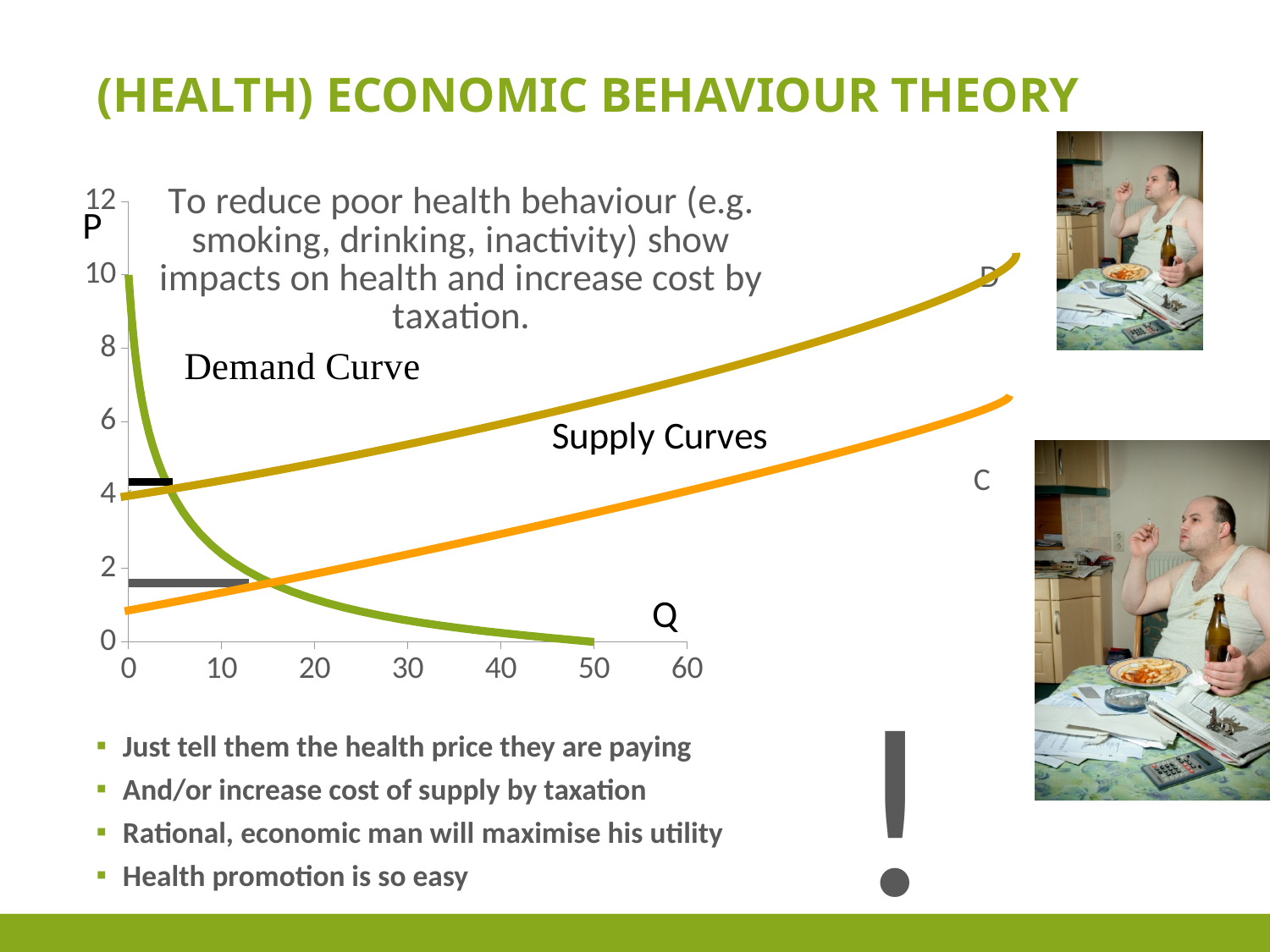
Is the value of the demand curve at Q = 50 greater or less than 2? less At Q = 60, which supply curve is higher, the olive one or the orange one? the olive one Does the demand curve rise or fall as Q increases? fall Do the supply curves rise or fall as Q increases? rise Is the value of the demand curve at Q = 10 greater or less than 4? less What kind of chart is shown on the slide? line chart What is the highest value shown on the vertical (P) axis? 12 What is the label on the horizontal axis of the chart? Q How many curves are plotted on the chart? 3 What is the highest value shown on the horizontal (Q) axis? 60 What is the label on the vertical axis of the chart? P